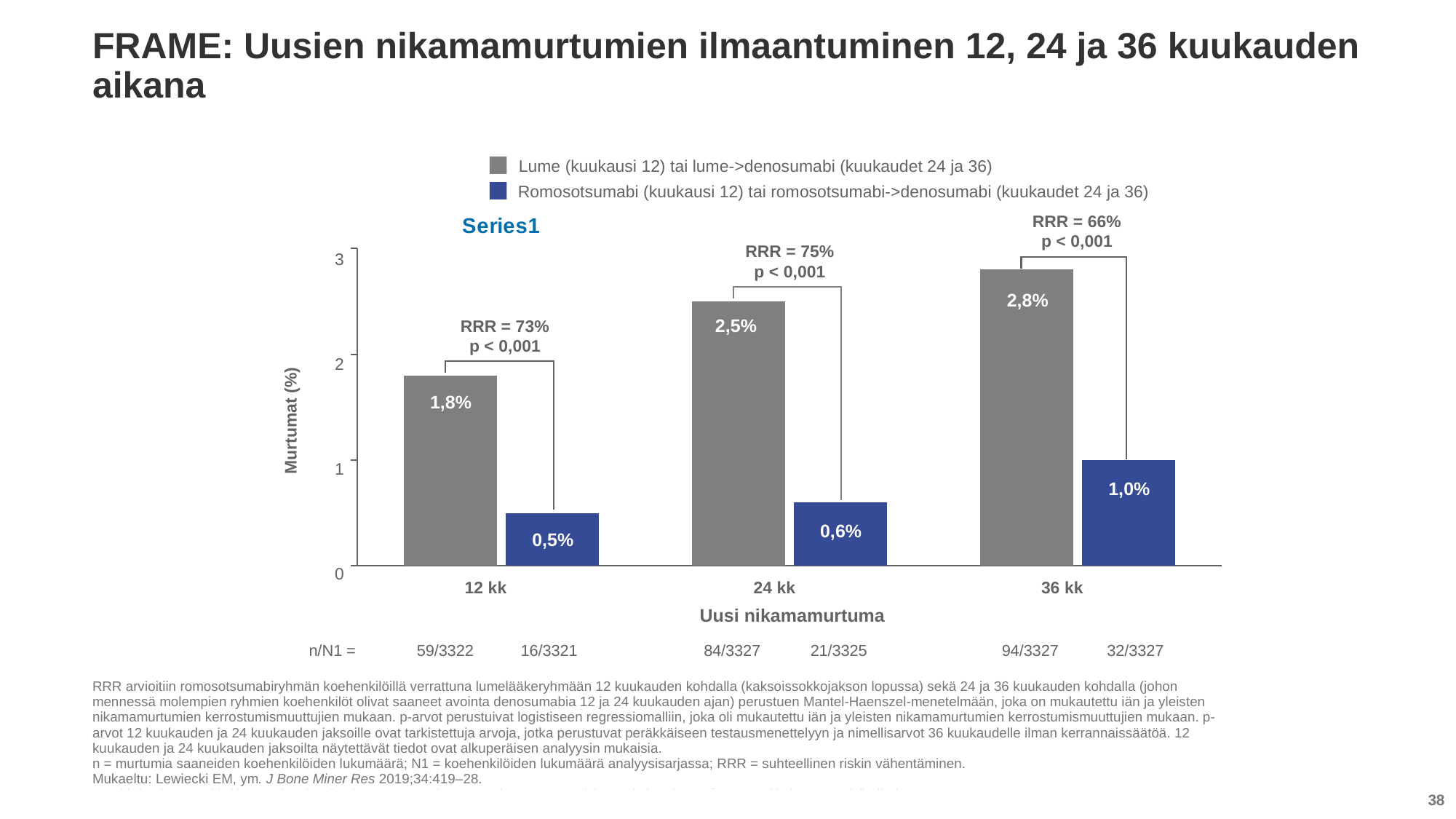
Is the value of the grey (Lume) bar at 36 kk greater or less than 2? greater At which time point is the grey (Lume) bar highest? 36 kk What is the value of the blue (Romosotsumabi) bar at 24 kk? 0,6% What is the value of the grey (Lume) bar at 24 kk? 2,5% How many time-point categories are shown on the x axis? 3 What is the value of the grey (Lume) bar at 12 kk? 1,8% How many series does the legend list? 2 At which time point is the blue (Romosotsumabi) bar lowest? 12 kk At 12 kk, which bar is larger, the grey (Lume) bar or the blue (Romosotsumabi) bar? Lume (grey) What kind of chart is shown on the slide? Bar chart What is the value of the blue (Romosotsumabi) bar at 36 kk? 1,0% What is the difference between the grey and blue bars at 36 kk? 1,8%